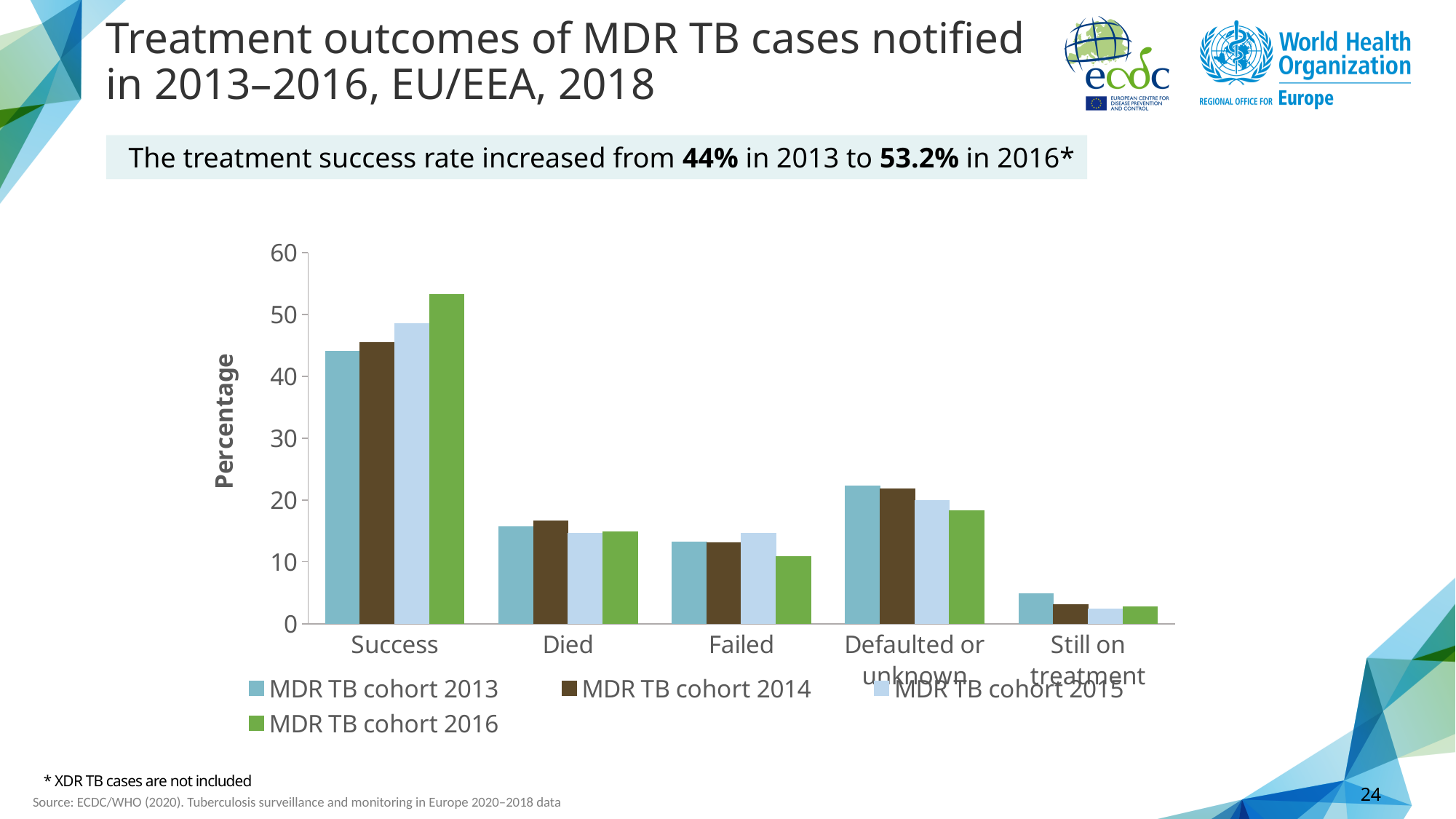
What kind of chart is shown on the slide? Bar chart Is the value for Failed in the MDR TB cohort 2016 greater or less than 15? less Which outcome category has the lowest value for the MDR TB cohort 2013? Still on treatment For the MDR TB cohort 2014, which is larger: the value for Died or the value for Failed? Died Does the Success value rise or fall from the 2013 cohort to the 2016 cohort? Rise Is the value for Defaulted or unknown in the MDR TB cohort 2013 greater or less than 20? greater By how many percentage points did the treatment success rate increase from the 2013 cohort to the 2016 cohort? 9.2 How many treatment outcome categories are shown on the x axis? 5 What was the treatment success rate for the MDR TB cohort 2016? 53.2% How many series does the legend list? 4 Which outcome category has the highest value for the MDR TB cohort 2016? Success What was the treatment success rate for the MDR TB cohort 2013? 44%